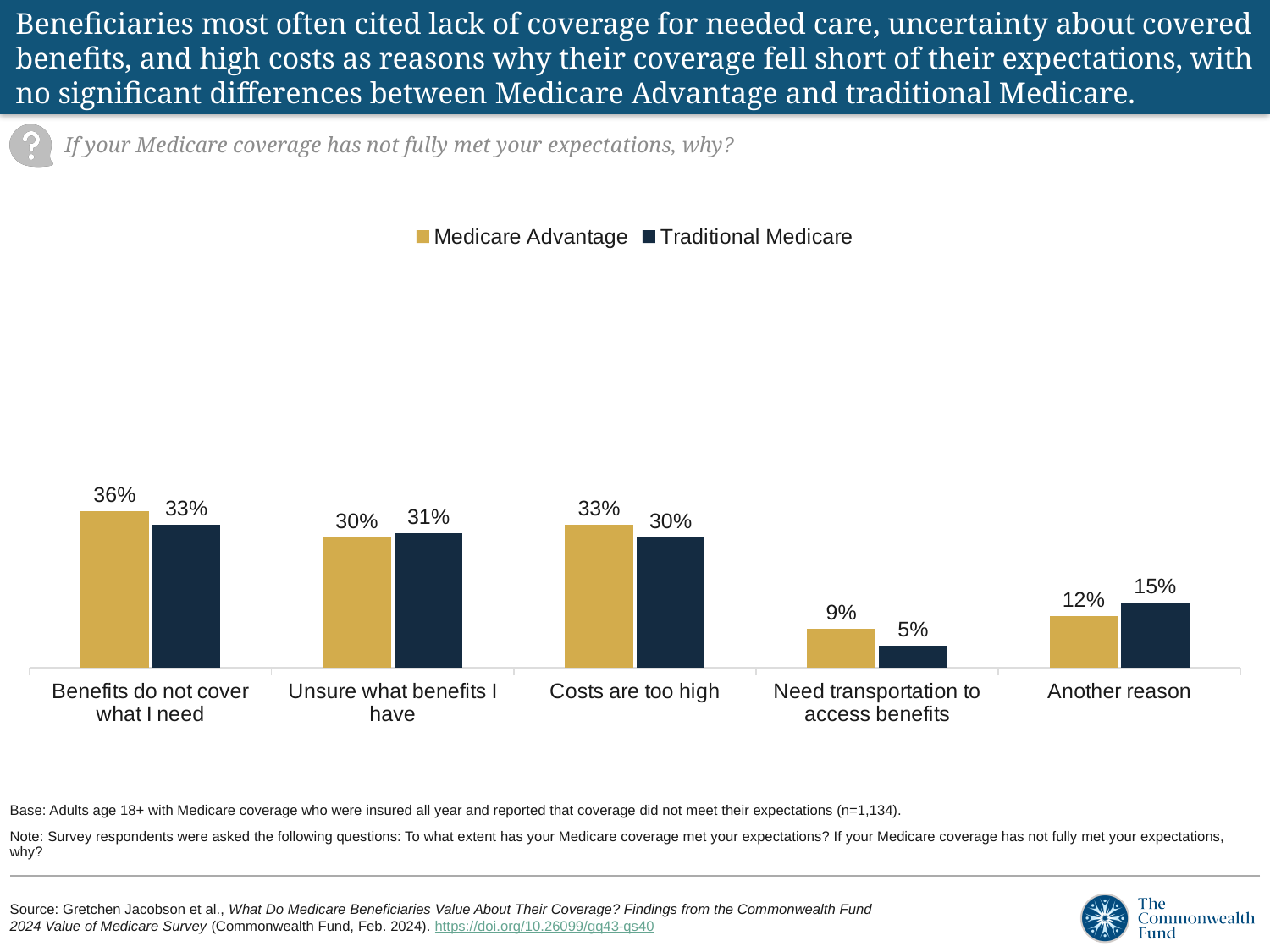
What is the difference between the Medicare Advantage and Traditional Medicare values for "Costs are too high"? 3 percentage points What is the Traditional Medicare value for "Another reason"? 15% What type of chart is shown on the slide? Bar chart What percentage of Medicare Advantage beneficiaries cited "Benefits do not cover what I need"? 36% How many series does the legend list? 2 Which reason has the lowest value for Traditional Medicare? Need transportation to access benefits Which colour represents Traditional Medicare in the chart? Dark navy blue What percentage of Traditional Medicare beneficiaries cited "Need transportation to access benefits"? 5% Which reason has the highest value for Medicare Advantage? Benefits do not cover what I need For "Need transportation to access benefits", which is larger: Medicare Advantage or Traditional Medicare? Medicare Advantage For "Another reason", which is larger: Medicare Advantage or Traditional Medicare? Traditional Medicare How many reason categories are shown on the x axis? 5